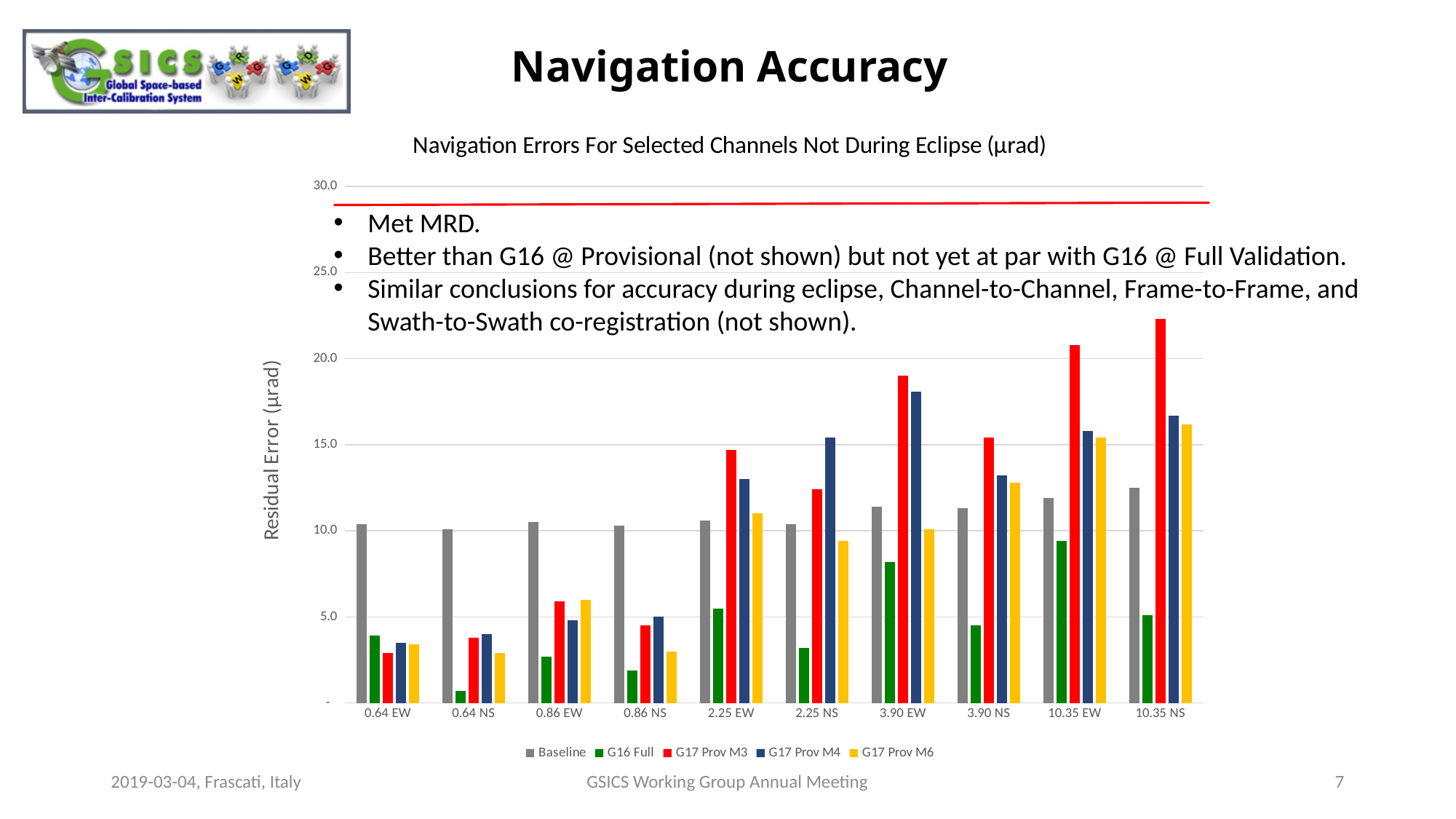
Which series and category has the highest bar in the chart? G17 Prov M3 at 10.35 NS At 0.64 EW, which is larger: Baseline or G17 Prov M3? Baseline Which series and category has the lowest bar in the chart? G16 Full at 0.64 NS What kind of chart is shown on the slide? Bar chart Is the value for G17 Prov M3 at 3.90 EW greater or less than 15.0? greater Is the value for G17 Prov M3 at 10.35 EW greater or less than 20.0? greater Is the value for G16 Full at 3.90 EW greater or less than 10.0? less How many channel categories are shown on the x axis? 10 How many series does the legend list? 5 At 10.35 NS, which is larger: G17 Prov M3 or G16 Full? G17 Prov M3 What is the label on the vertical axis of the chart? Residual Error (μrad)